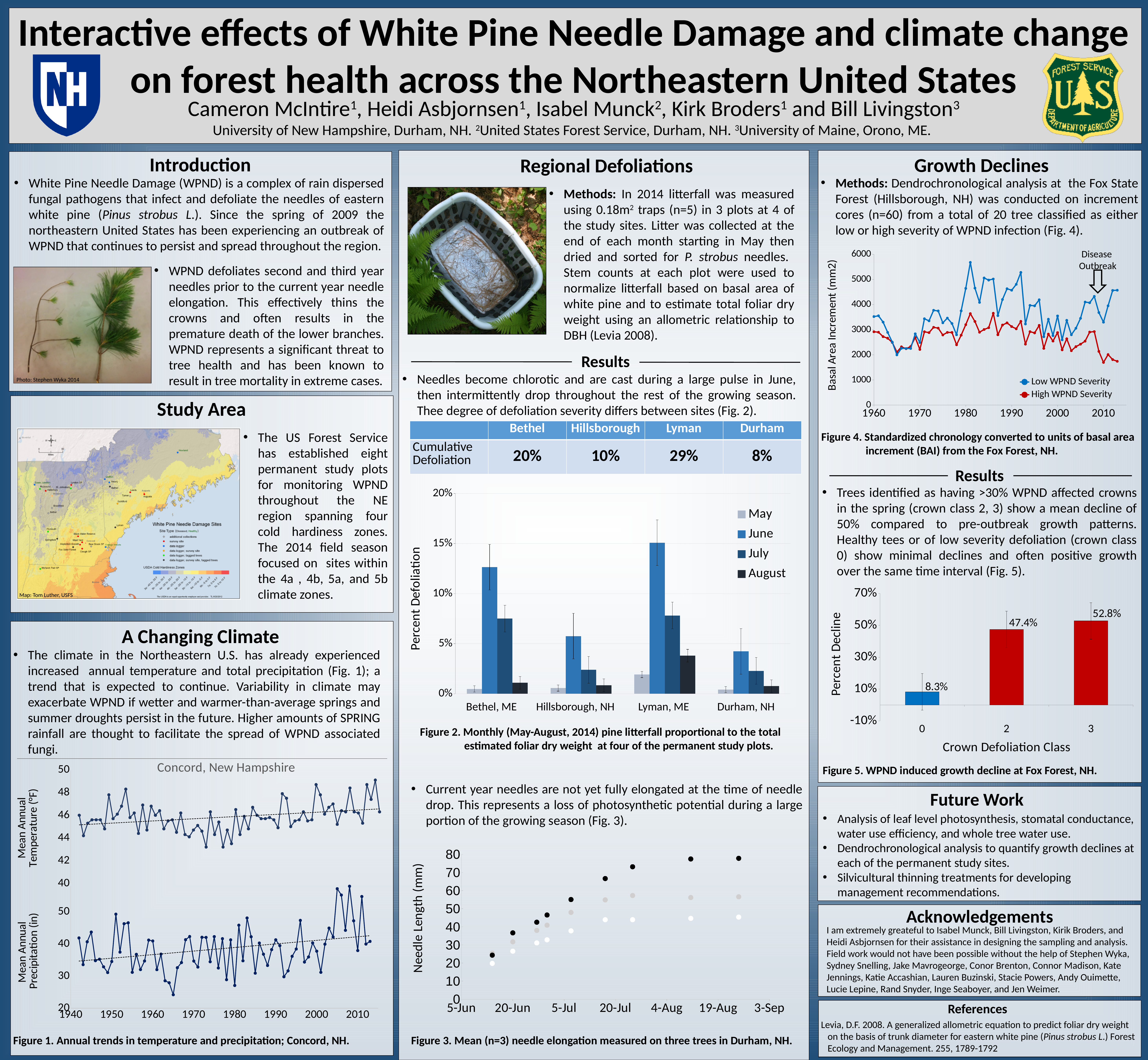
In Figure 5 (WPND induced growth decline at Fox Forest), what is the percent decline for crown defoliation class 2? 47.4% In Figure 2 (monthly pine litterfall), is the June percent defoliation for Hillsborough, NH greater or less than 10%? less In Figure 4 (basal area increment chronology), what are the two series listed in the legend? Low WPND Severity and High WPND Severity In Figure 5 (WPND induced growth decline), how many crown defoliation classes are plotted? 3 In Figure 5 (WPND induced growth decline), what is the percent decline for crown defoliation class 0? 8.3% What kind of chart is Figure 3 (needle elongation in Durham, NH)? scatter chart In Figure 5 (WPND induced growth decline), which crown defoliation class has the highest percent decline? 3 In Figure 2 (monthly pine litterfall), how many series does the legend list? 4 In Figure 2 (monthly pine litterfall), which is larger: the June value for Bethel, ME or the June value for Durham, NH? Bethel, ME In Figure 4 (basal area increment chronology), around 2010, which series has the higher basal area increment? Low WPND Severity In Figure 5 (WPND induced growth decline), what is the difference in percent decline between crown defoliation class 3 and class 2? 5.4% In Figure 2 (monthly pine litterfall), which site has the highest June percent defoliation? Lyman, ME